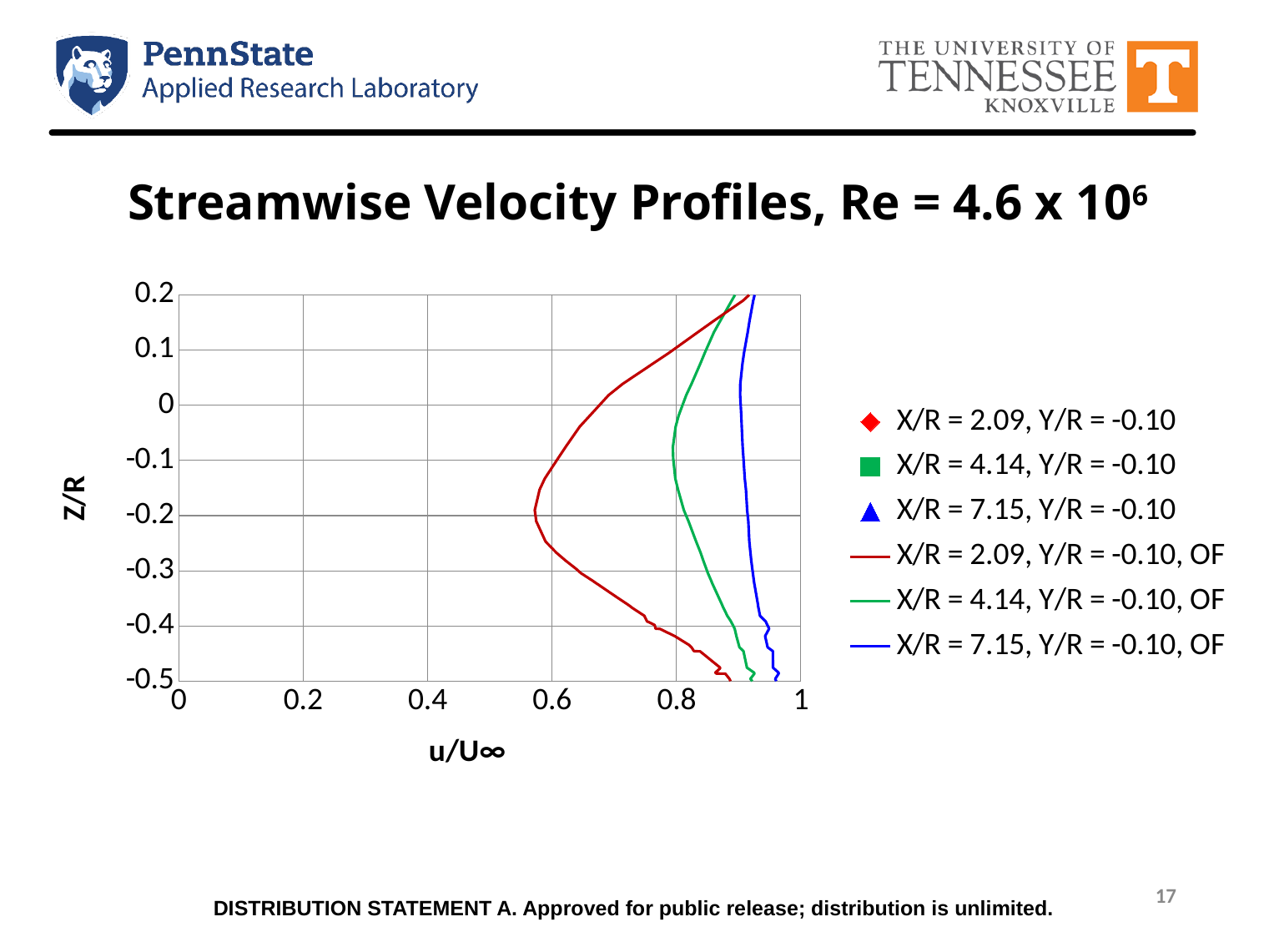
Which curve reaches the lowest u/U∞ value on the chart? X/R = 2.09, Y/R = -0.10, OF Is the u/U∞ value of the red curve (X/R = 2.09, OF) at Z/R = 0 greater or less than 0.6? greater How many series does the legend list? 6 Which curve has the highest u/U∞ values across the plotted Z/R range? X/R = 7.15, Y/R = -0.10, OF What is the label of the horizontal axis? u/U∞ For the red curve (X/R = 2.09, OF), does u/U∞ rise or fall as Z/R increases from -0.2 to 0.2? rise At Z/R = -0.2, which curve has the larger u/U∞: the red curve (X/R = 2.09, OF) or the blue curve (X/R = 7.15, OF)? X/R = 7.15, Y/R = -0.10, OF What kind of chart is shown on the slide? line chart What is the title of the chart? Streamwise Velocity Profiles, Re = 4.6 x 10^6 Is the u/U∞ value of the blue curve (X/R = 7.15, OF) at Z/R = 0.2 greater or less than 0.8? greater Is the minimum u/U∞ of the red curve (X/R = 2.09, OF) greater or less than 0.6? less